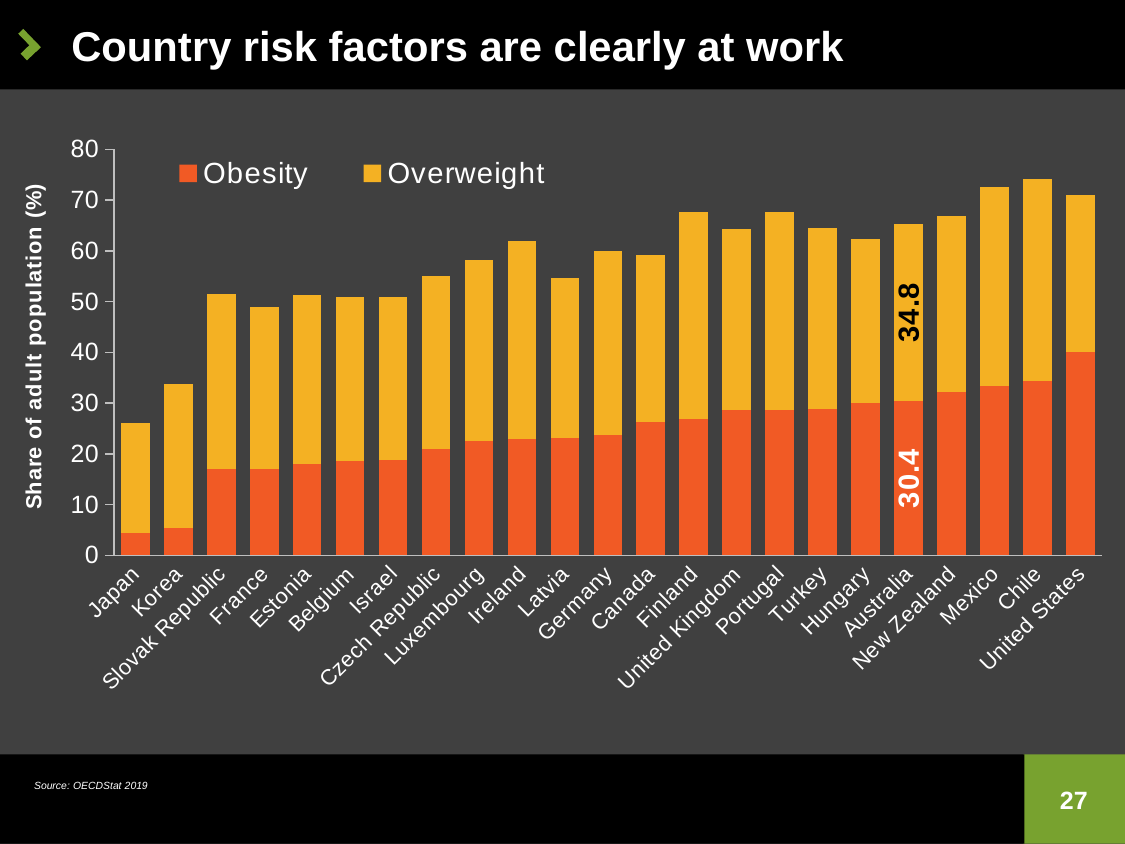
How many series does the legend list? 2 Is the Obesity value for the United States greater or less than 30? greater What is the Overweight value for Australia? 34.8 Is the total stacked bar for Japan greater or less than 30? less What is the total height of the stacked bar for Australia (Obesity plus Overweight)? 65.2 What kind of chart is shown on the slide? Stacked bar chart Which country has the highest Obesity value? United States How many countries are shown on the x axis? 23 Which has the larger Obesity value, Korea or Mexico? Mexico What is the Obesity value for Australia? 30.4 Which country has the lowest combined Obesity and Overweight bar? Japan Which country has the lowest Obesity value? Japan